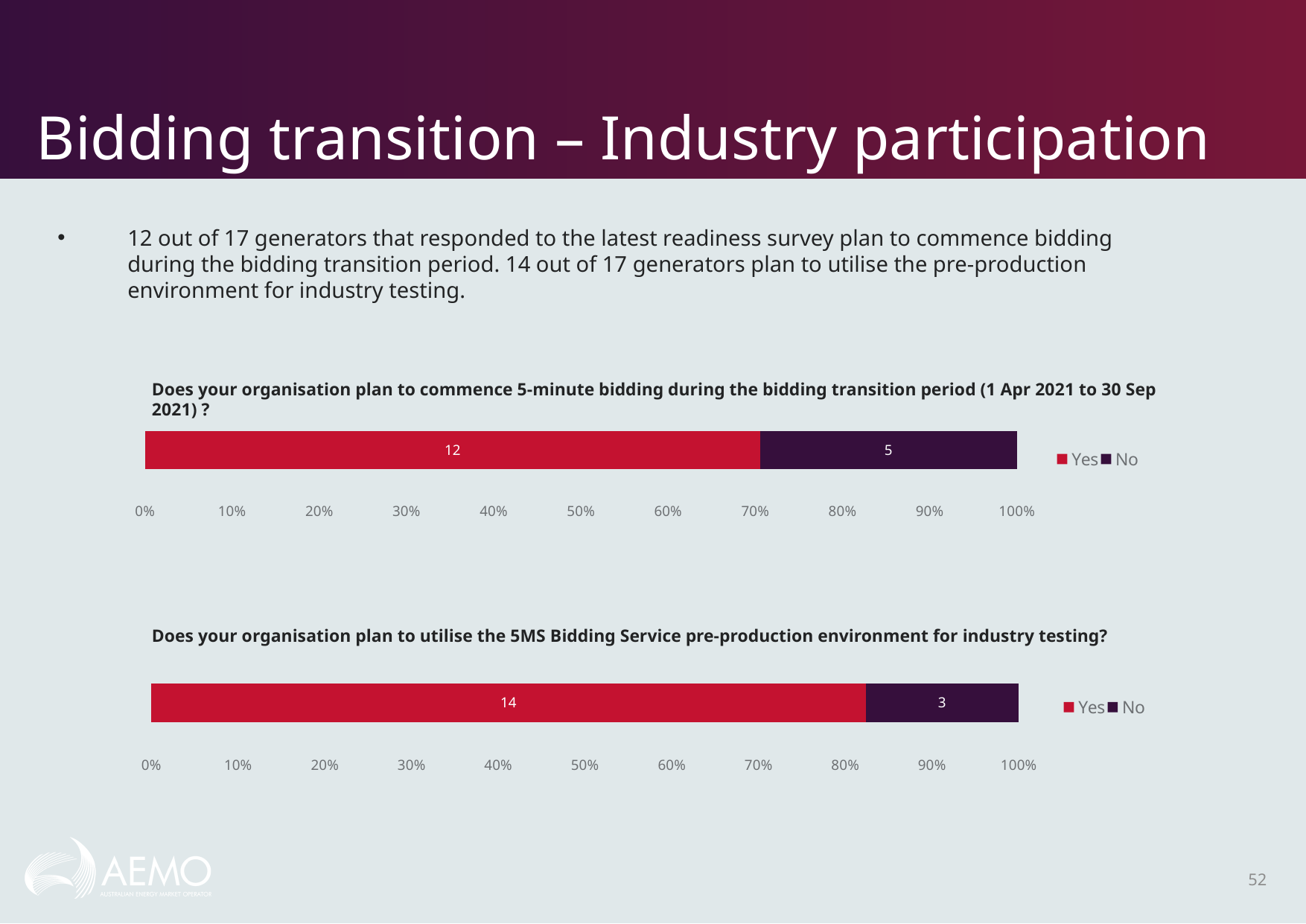
In the top chart (commence 5-minute bidding during the transition period), what is the value for Yes? 12 How many series does the legend of the top chart list? 2 In the top chart, is the Yes segment greater or less than 50% of the bar? greater In the top chart, what is the difference between the Yes and No values? 7 In the top chart (commence 5-minute bidding during the transition period), what is the value for No? 5 In the top chart, what is the total of the stacked bar (Yes plus No)? 17 In the bottom chart, which is larger, Yes or No? Yes In the bottom chart (utilise the pre-production environment for industry testing), what is the value for Yes? 14 In the bottom chart, what is the total of the stacked bar (Yes plus No)? 17 What kind of chart is the bottom chart? Stacked bar chart In the bottom chart, what is the difference between the Yes and No values? 11 In the bottom chart (utilise the pre-production environment for industry testing), what is the value for No? 3